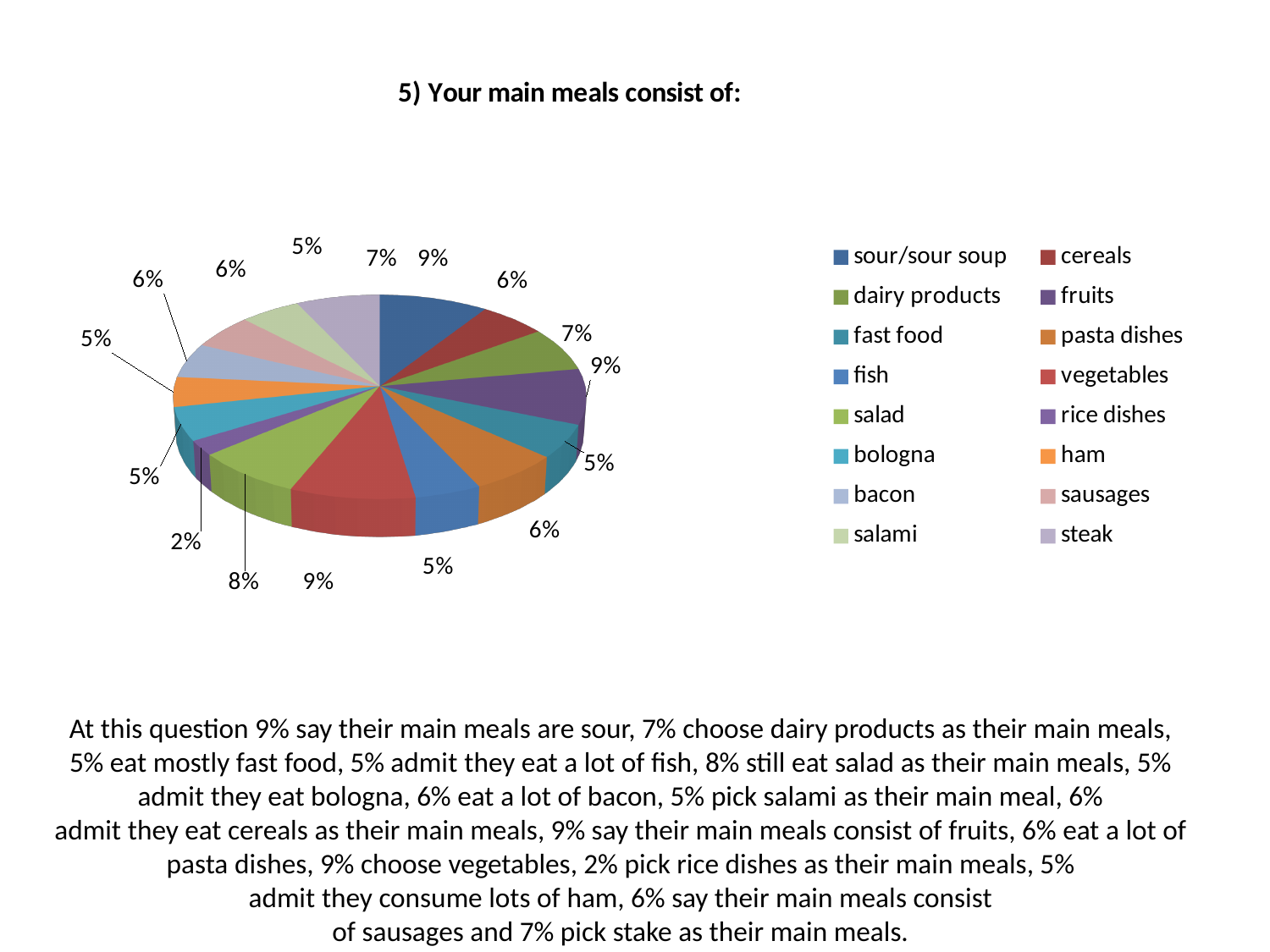
Which category has the smallest slice of the pie? rice dishes What share of the pie is dairy products? 7% What share of the pie is rice dishes? 2% What is the title of the chart? 5) Your main meals consist of: What share of the pie is salad? 8% Which is larger, the slice for salad or the slice for fish? salad What kind of chart is shown on the slide? pie chart What is the difference between the share for vegetables and the share for rice dishes? 7% How many categories does the legend of the pie chart list? 16 What is the difference between the share for salad and the share for bologna? 3%